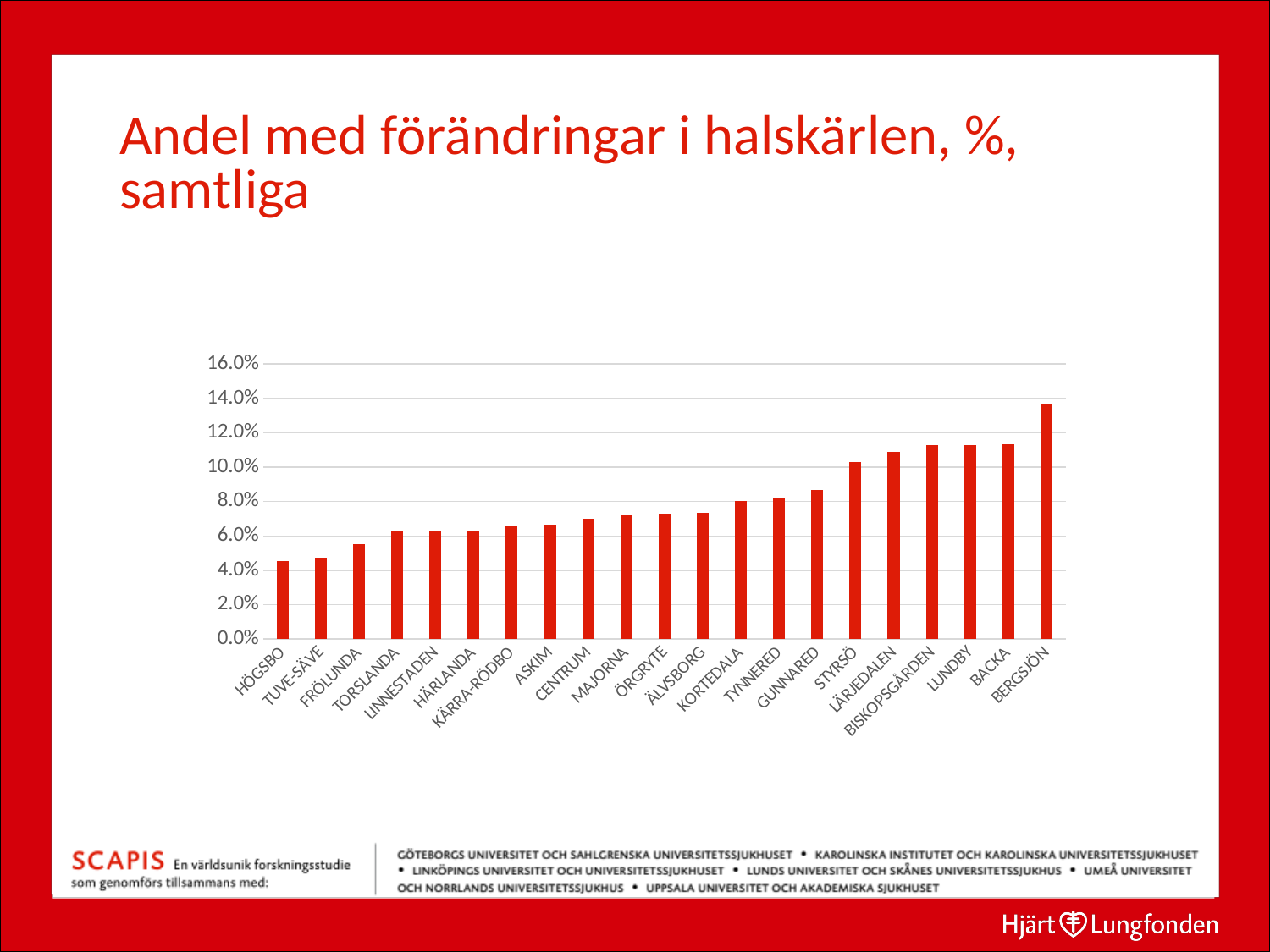
Is the value for GUNNARED greater or less than 10.0%? less Do the bar values generally rise or fall from left to right along the x axis? rise Is the value for HÖGSBO greater or less than 6.0%? less Which district has the highest share of changes in the carotid arteries? BERGSJÖN Which has the larger value, ASKIM or GUNNARED? GUNNARED Which has the larger value, STYRSÖ or CENTRUM? STYRSÖ How many districts (categories) are shown on the x axis of the chart? 21 Is the value for BERGSJÖN greater or less than 12.0%? greater What kind of chart is shown on the slide? bar chart What is the title of the slide containing the chart? Andel med förändringar i halskärlen, %, samtliga